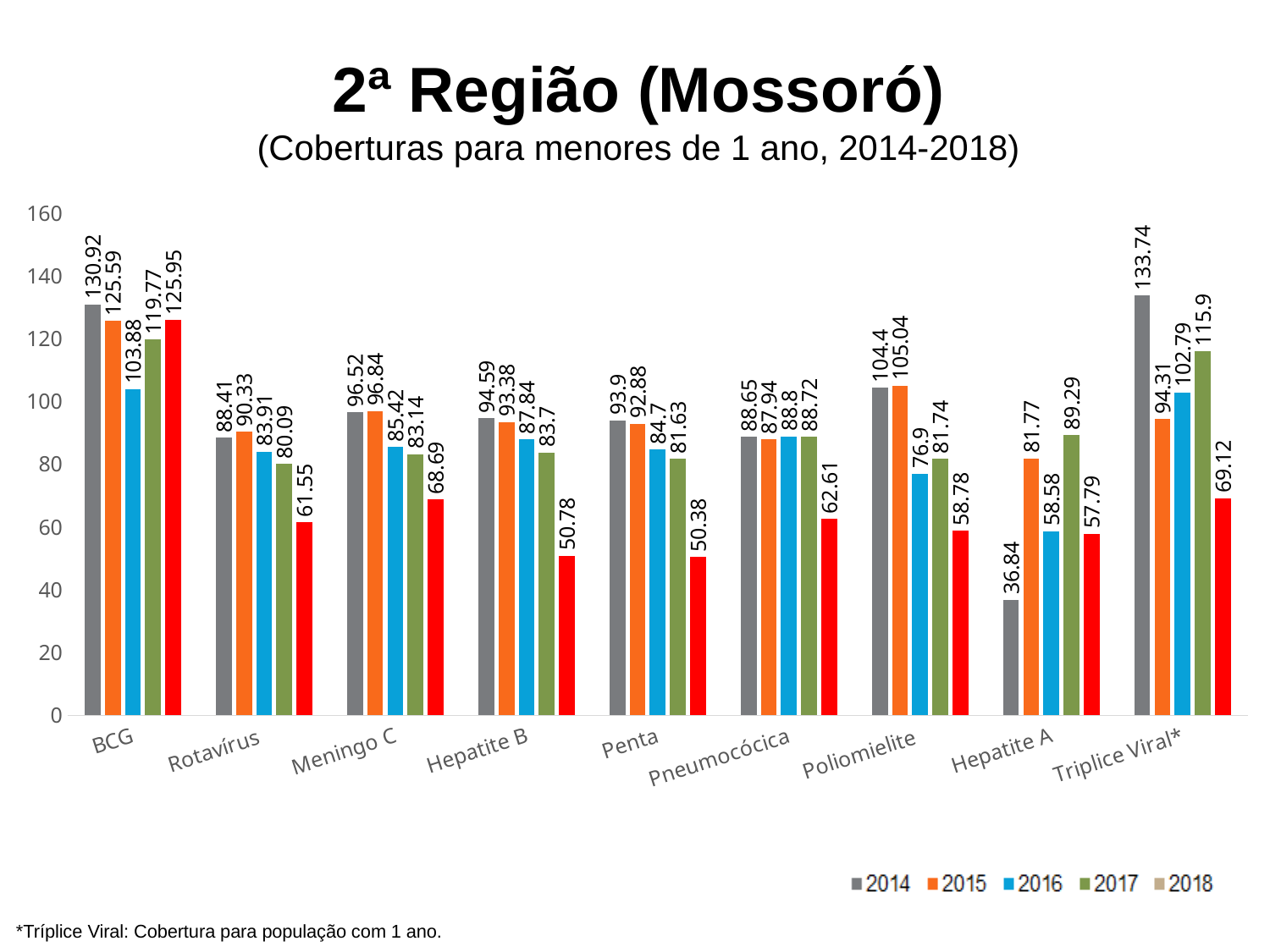
For Poliomielite, which year has the larger value, 2014 or 2015? 2015 What is the difference between the 2014 and 2018 values for Hepatite B? 43.81 What is the value for Hepatite A in 2014? 36.84 What is the difference between the 2014 and 2018 values for BCG? 4.97 What is the value for BCG in 2014? 130.92 How many vaccine categories are shown on the x axis? 9 Do the values for Hepatite B rise or fall from 2014 to 2018? fall Which category has the highest value for 2014? Tríplice Viral* How many series does the legend list? 5 What is the value for Tríplice Viral* in 2017? 115.9 Which category has the lowest value for 2014? Hepatite A Is the 2018 value for Rotavírus greater or less than 80? less